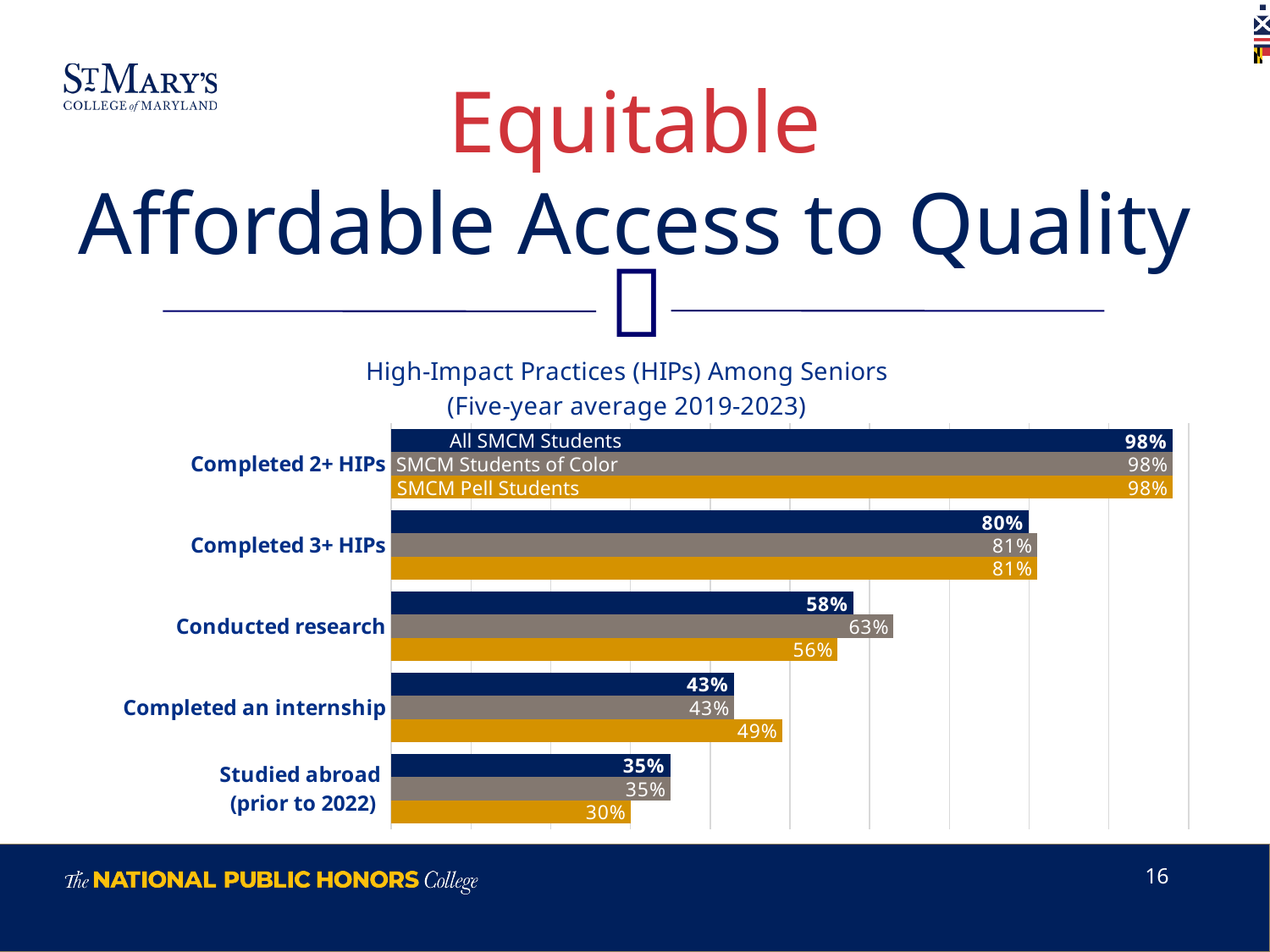
What type of chart is used to show High-Impact Practices Among Seniors? Bar chart Which high-impact practice has the lowest value for SMCM Pell Students? Studied abroad (prior to 2022) For Completed an internship, which group has the larger value: All SMCM Students or SMCM Pell Students? SMCM Pell Students What percentage of SMCM Pell Students completed an internship? 49% What percentage of SMCM Pell Students studied abroad (prior to 2022)? 30% How many student groups (series) are shown in the chart? 3 Which high-impact practice has the highest value for All SMCM Students? Completed 2+ HIPs How many high-impact practice categories are shown on the chart? 5 What time period does the chart subtitle say the data averages? Five-year average 2019-2023 What percentage of SMCM Students of Color conducted research? 63% What is the difference between SMCM Students of Color and SMCM Pell Students for Conducted research? 7% What percentage of All SMCM Students completed 3+ HIPs? 80%